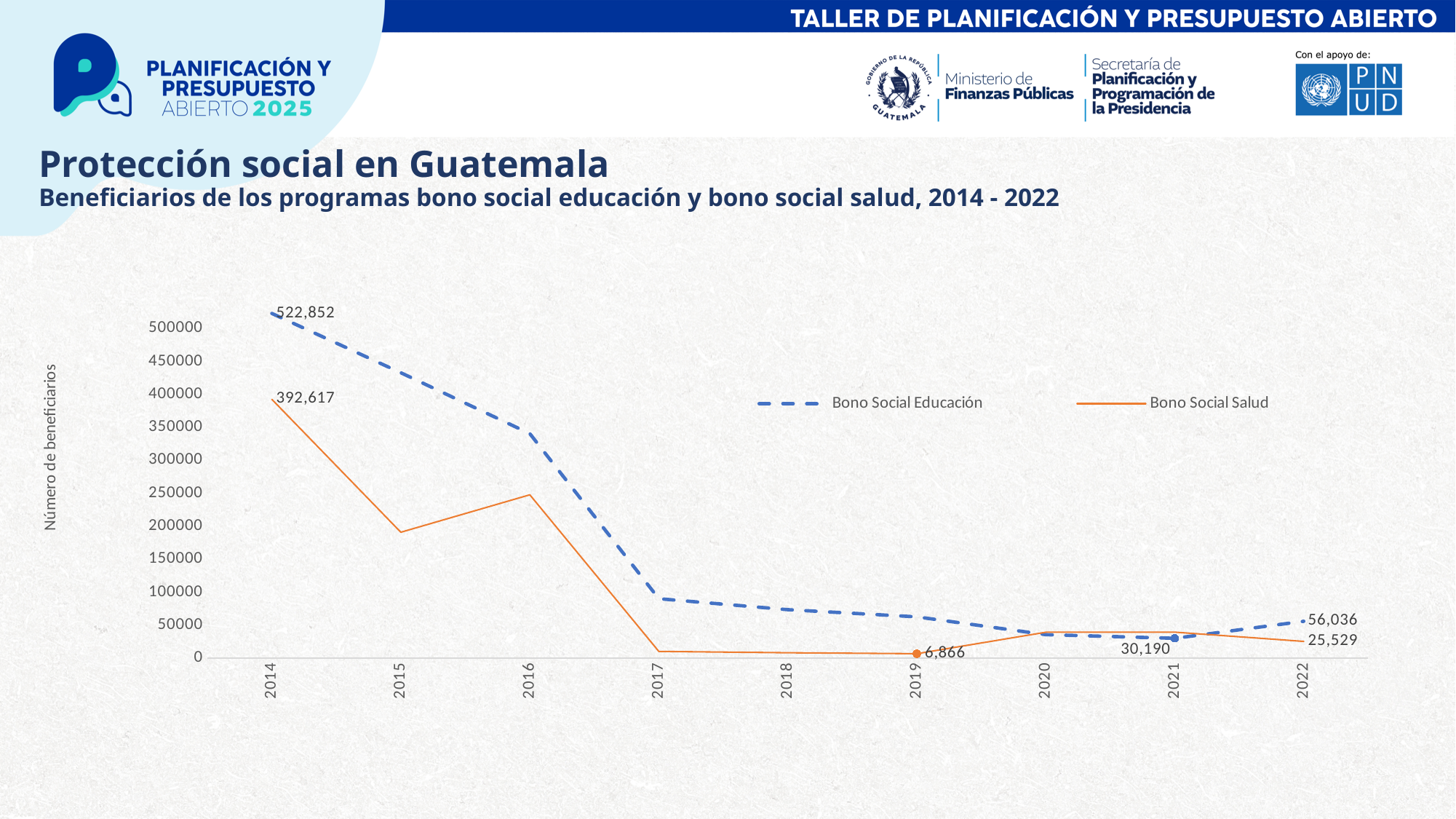
What is the value for Bono Social Salud in 2014? 392,617 What kind of chart is shown on the slide? Line chart What is the value for Bono Social Salud in 2019? 6,866 What is the value for Bono Social Educación in 2021? 30,190 How many years are plotted on the x axis? 9 What is the difference between Bono Social Educación and Bono Social Salud in 2014? 130,235 Is the value for Bono Social Salud in 2016 greater or less than 200000? greater How many series does the legend list? 2 What is the value for Bono Social Educación in 2022? 56,036 What is the value for Bono Social Educación in 2014? 522,852 Which series has the larger value in 2022, Bono Social Educación or Bono Social Salud? Bono Social Educación What is the value for Bono Social Salud in 2022? 25,529